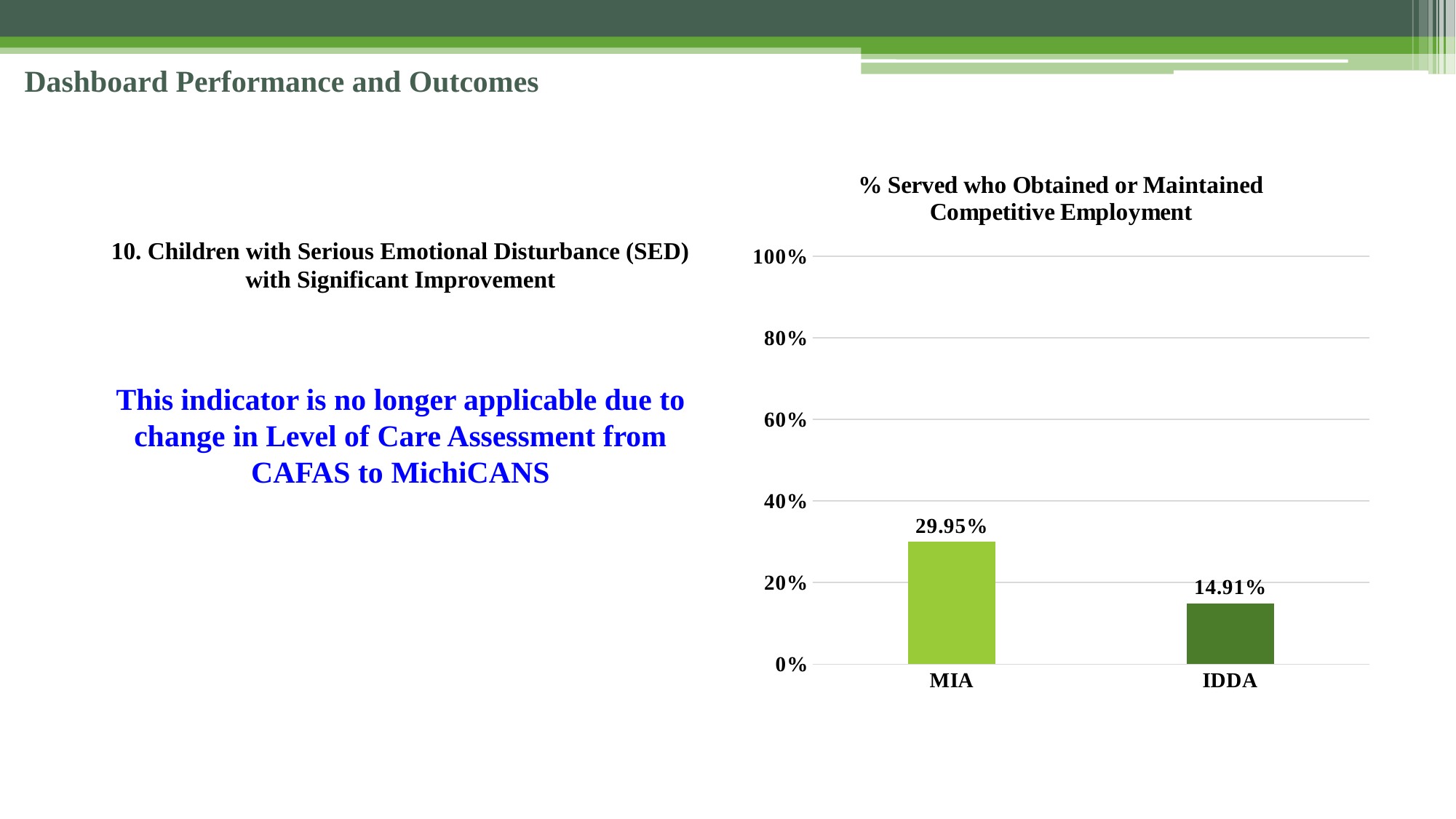
Which category has the lowest value in the chart? IDDA Is the value for MIA greater or less than 40%? less What kind of chart is shown on the slide? bar chart Is the value for IDDA greater or less than 20%? less What is the value for MIA in the chart? 29.95% What is the title of the chart? % Served who Obtained or Maintained Competitive Employment What is the value for IDDA in the chart? 14.91% Which category has the highest value in the chart? MIA Which is larger, the value for MIA or the value for IDDA? MIA What is the highest value shown on the chart's vertical axis? 100% What is the difference between the values for MIA and IDDA? 15.04% How many categories are shown in the chart? 2